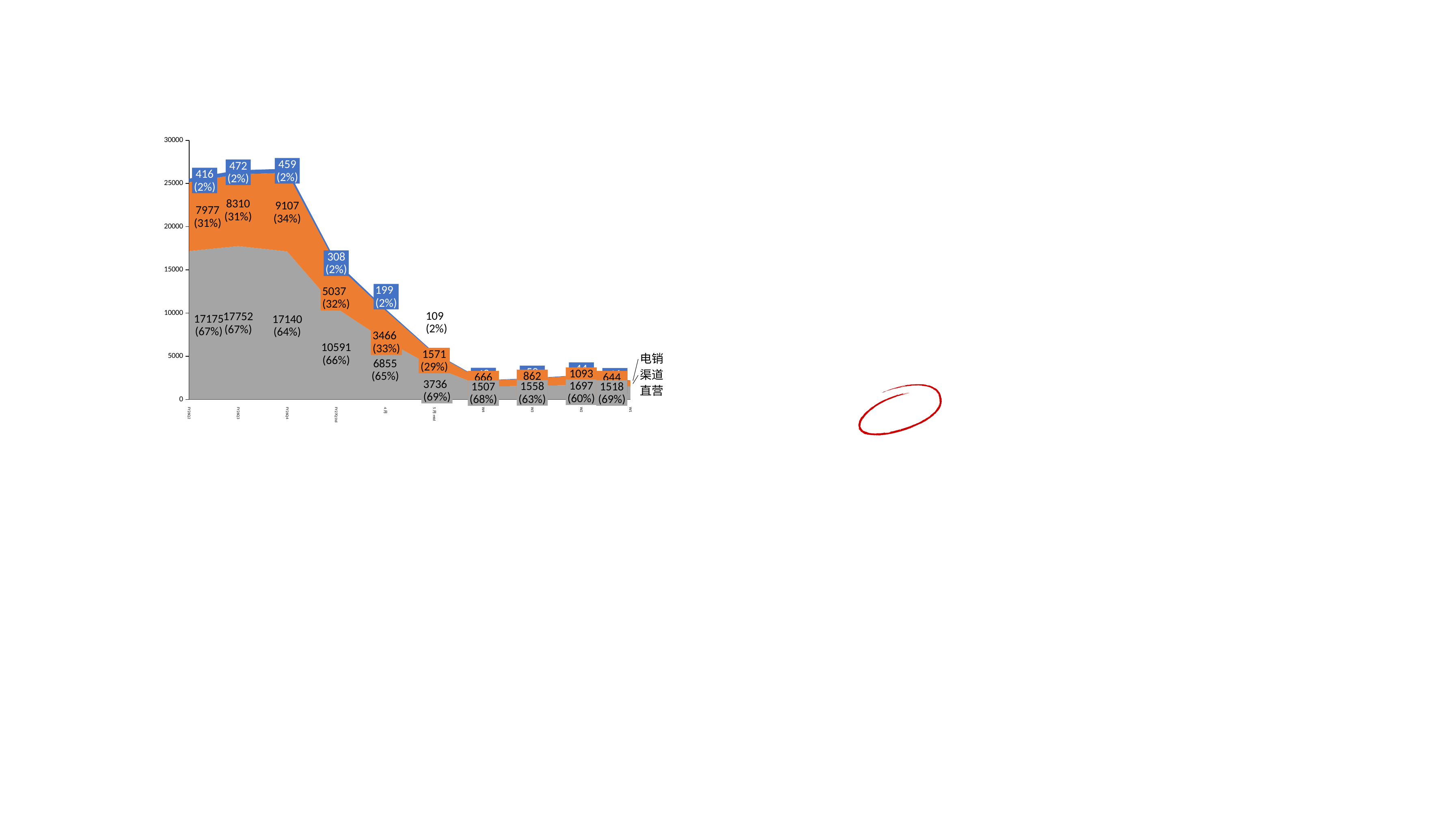
What are the three series labels shown at the right edge of the chart? 电销, 渠道, 直营 What is the 渠道 (orange) value at the third point from the left? 9107 What is the difference between the 直营 values at the second point (17752) and the first point (17175)? 577 Which is larger: the 渠道 value at the third point (9107) or at the second point (8310)? 9107 at the third point What percentage share is shown for 渠道 at the sixth point from the left (the one labelled 1571)? 29% At which point does the 直营 (gray) series reach its highest value? the second point from the left (17752) What kind of chart is shown on the slide? stacked area chart What is the 电销 (blue) value at the fourth point from the left? 308 What is the 直营 (gray) value at the leftmost point of the chart? 17175 What is the total of the three series at the leftmost point (416 + 7977 + 17175)? 25568 How many points are plotted along the x axis of the chart? 10 How many series does the chart show (as labelled at the right edge)? 3